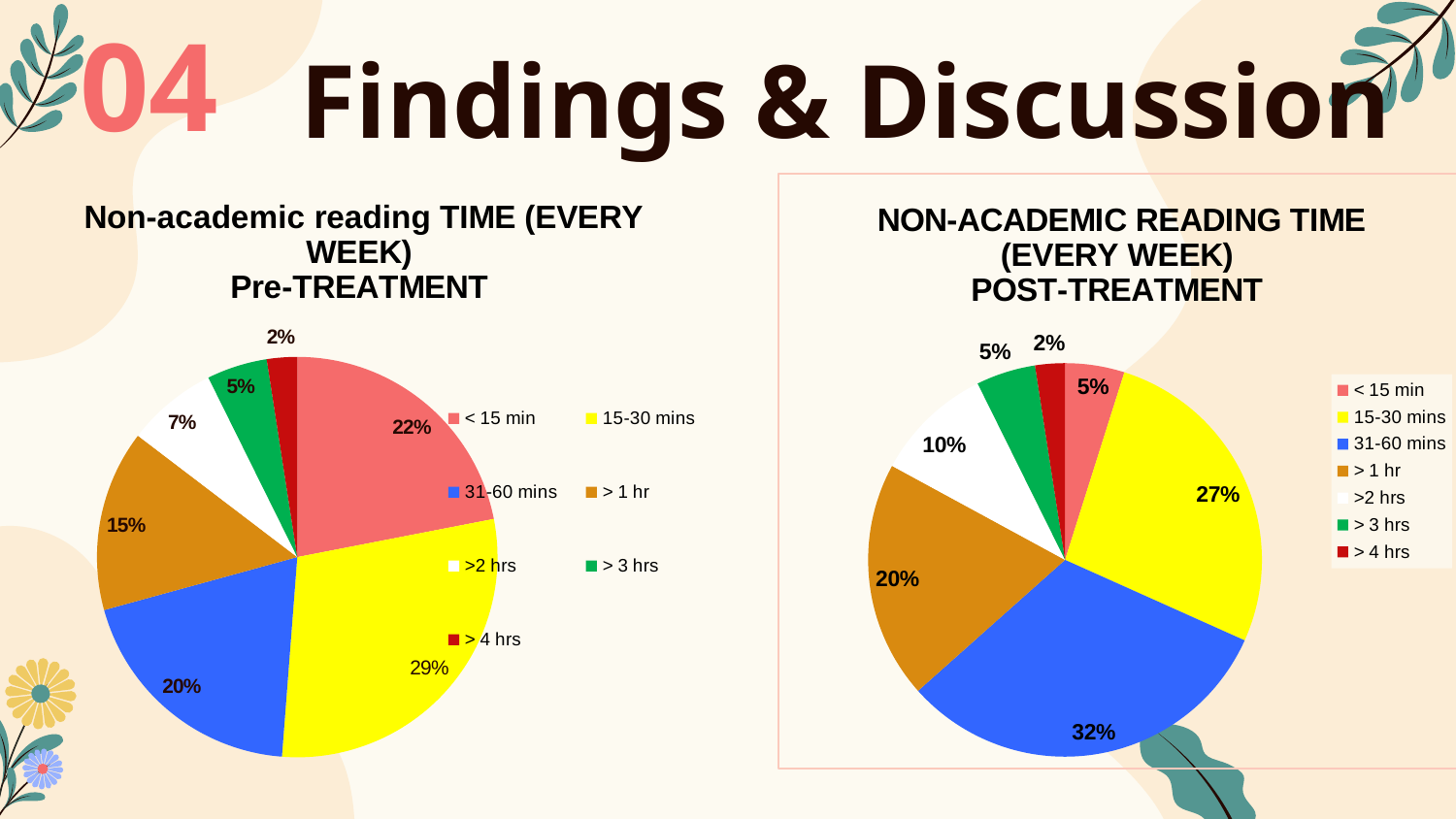
In the Pre-TREATMENT pie chart, what colour represents the 31-60 mins category? Blue In the POST-TREATMENT pie chart, what share is labelled for the < 15 min slice? 5% What type of chart is used for the Pre-TREATMENT data? Pie chart In the POST-TREATMENT pie chart, which category has the largest slice? 31-60 mins In the POST-TREATMENT pie chart, which is larger: the > 1 hr slice or the >2 hrs slice? > 1 hr In the Pre-TREATMENT pie chart, which category has the smallest slice? > 4 hrs How many categories does the legend of the POST-TREATMENT pie chart list? 7 In the Pre-TREATMENT pie chart, what share is labelled for the 15-30 mins slice? 29% What is the difference between the < 15 min share in the Pre-TREATMENT chart and the < 15 min share in the POST-TREATMENT chart? 17% In the POST-TREATMENT pie chart, what share is labelled for the 31-60 mins slice? 32% In the Pre-TREATMENT pie chart, which category has the largest slice? 15-30 mins In the Pre-TREATMENT pie chart, what share is labelled for the > 1 hr slice? 15%